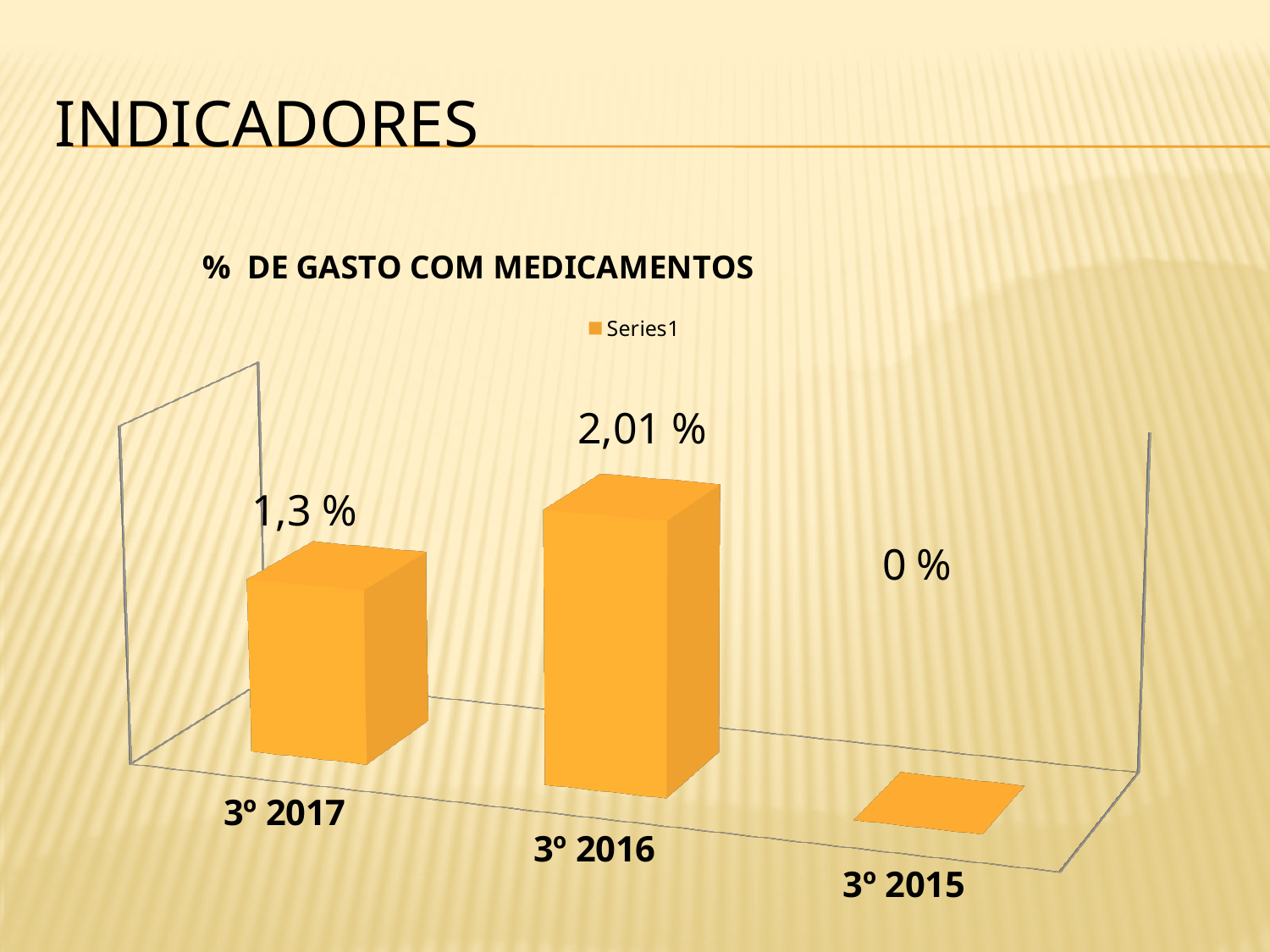
What is the value for 3º 2015? 0 % How many series does the legend list? 1 What is the title of the chart? % DE GASTO COM MEDICAMENTOS What is the value for 3º 2016? 2,01 % How many categories are shown in the chart? 3 What is the difference between the values for 3º 2017 and 3º 2015? 1,3 % Which category has the lowest value? 3º 2015 What is the value for 3º 2017? 1,3 % What kind of chart is shown on the slide? Bar chart Which is larger, the value for 3º 2017 or the value for 3º 2016? 3º 2016 Which category has the highest value? 3º 2016 What is the difference between the values for 3º 2016 and 3º 2017? 0,71 %